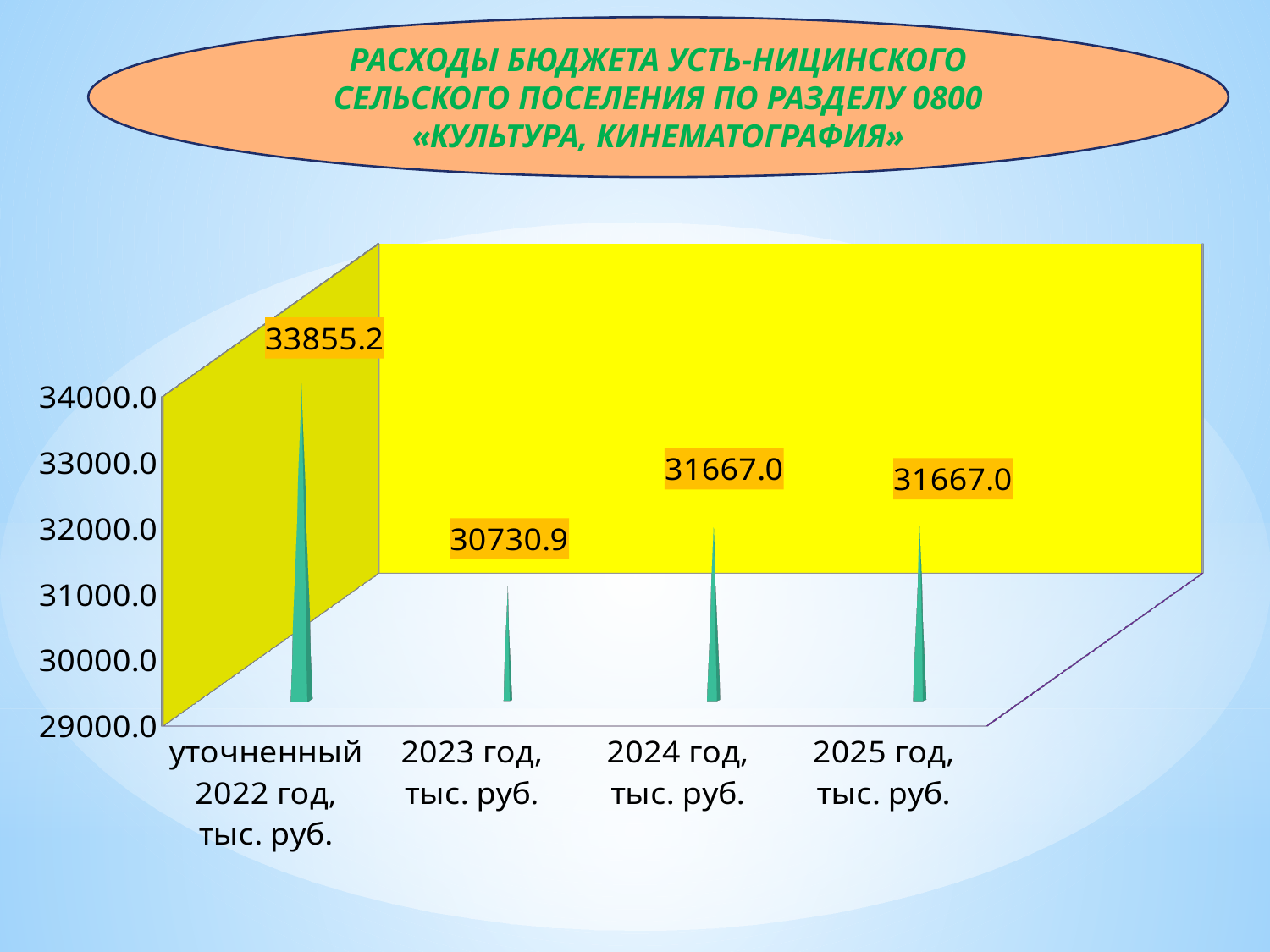
What is the difference between the values for уточненный 2022 год and 2023 год? 3124.3 Is the value for 2023 год greater or less than 31000.0? less What is the value for 2023 год, тыс. руб.? 30730.9 How many categories are shown on the x axis? 4 Which is larger, the value for уточненный 2022 год or the value for 2024 год? уточненный 2022 год What kind of chart is shown on the slide? bar chart What is the value for 2024 год, тыс. руб.? 31667.0 Which category has the lowest value? 2023 год, тыс. руб. Which category has the highest value? уточненный 2022 год, тыс. руб. What is the value for уточненный 2022 год, тыс. руб.? 33855.2 What is the value for 2025 год, тыс. руб.? 31667.0 What is the difference between the values for 2024 год and 2023 год? 936.1